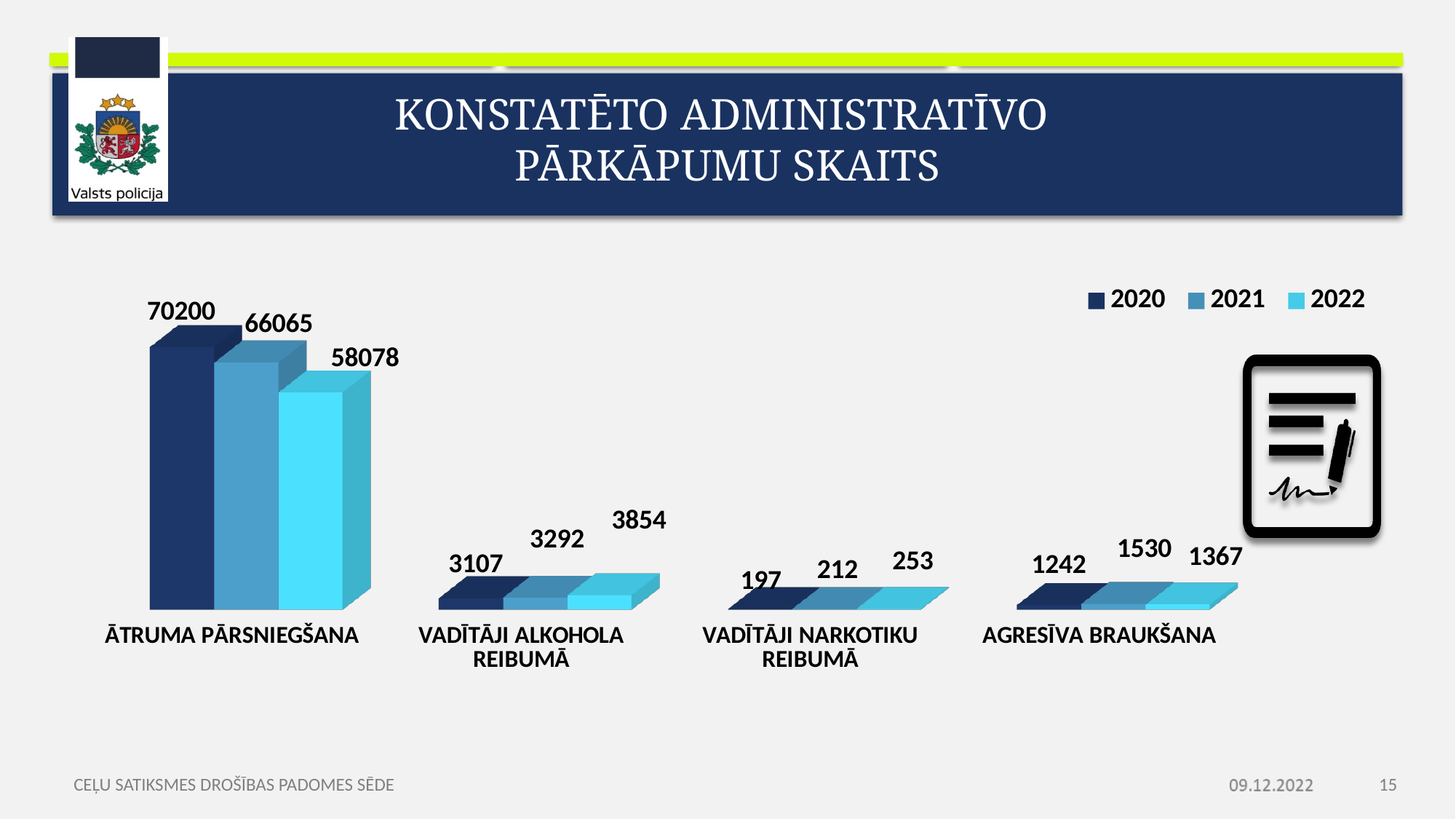
Which category has the highest value in 2022? ĀTRUMA PĀRSNIEGŠANA What kind of chart is shown on the slide? bar chart Which category has the lowest value in 2021? VADĪTĀJI NARKOTIKU REIBUMĀ What is the value for AGRESĪVA BRAUKŠANA in 2021? 1530 How many series does the legend list? 3 What is the value for ĀTRUMA PĀRSNIEGŠANA in 2020? 70200 What is the value for VADĪTĀJI NARKOTIKU REIBUMĀ in 2020? 197 Which is larger for AGRESĪVA BRAUKŠANA: the 2021 value or the 2022 value? 2021 Do the values for VADĪTĀJI ALKOHOLA REIBUMĀ rise or fall from 2020 to 2022? rise How many categories are shown on the x axis? 4 What is the value for VADĪTĀJI ALKOHOLA REIBUMĀ in 2022? 3854 What is the difference between the 2020 and 2022 values for ĀTRUMA PĀRSNIEGŠANA? 12122